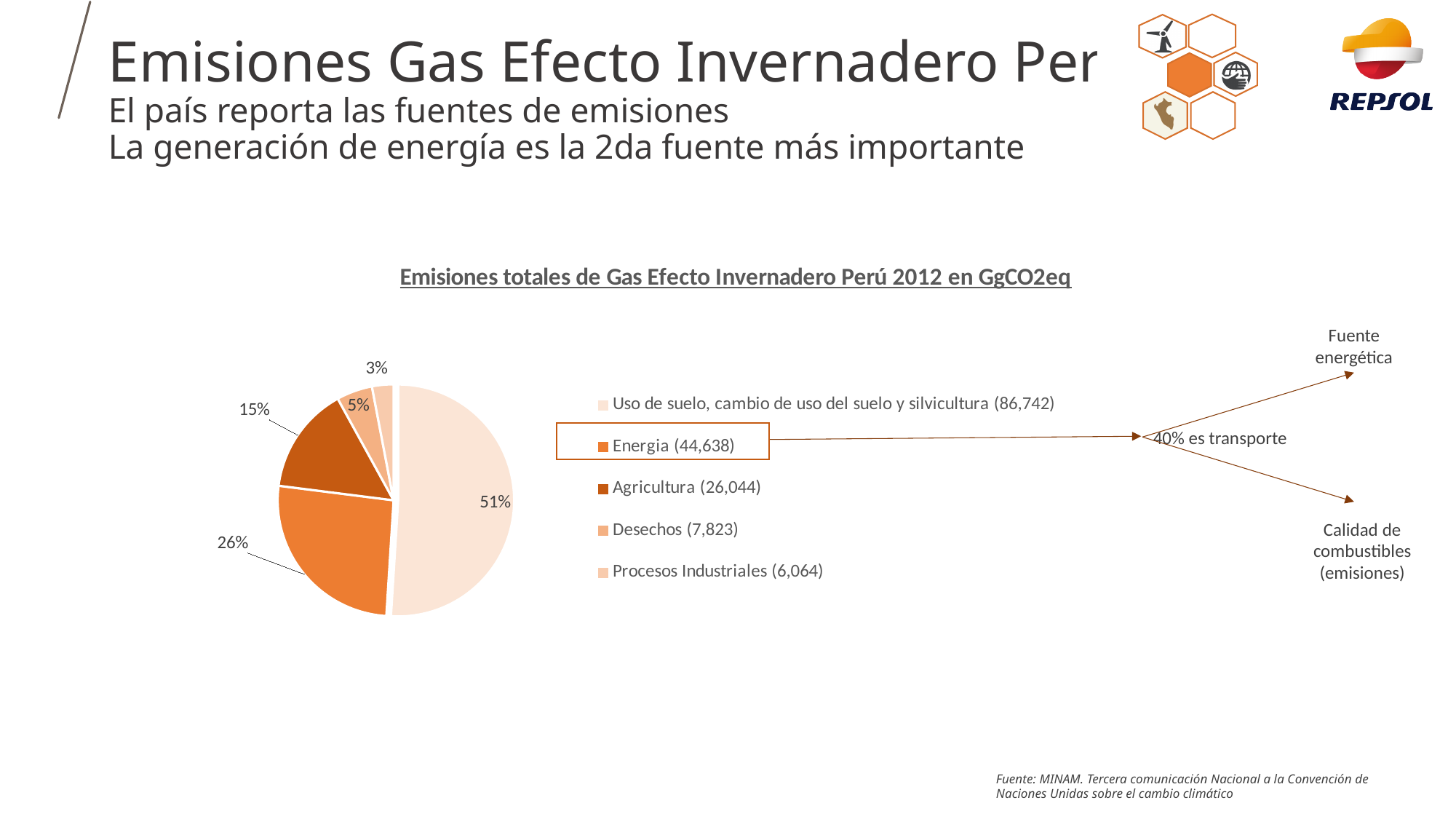
What value is shown for Energia in the legend? 44,638 What value is shown for Agricultura in the legend? 26,044 Which category has the largest slice of the pie? Uso de suelo, cambio de uso del suelo y silvicultura How many categories does the pie chart have? 5 What share of the pie does Procesos Industriales represent? 3% What share of the pie does Uso de suelo, cambio de uso del suelo y silvicultura represent? 51% Which is larger, the value for Desechos or the value for Procesos Industriales? Desechos What is the difference between the values for Energia and Agricultura? 18,594 What type of chart is shown on the slide? pie chart Which category has the smallest slice of the pie? Procesos Industriales What value is shown for Desechos in the legend? 7,823 What is the title of the chart? Emisiones totales de Gas Efecto Invernadero Perú 2012 en GgCO2eq